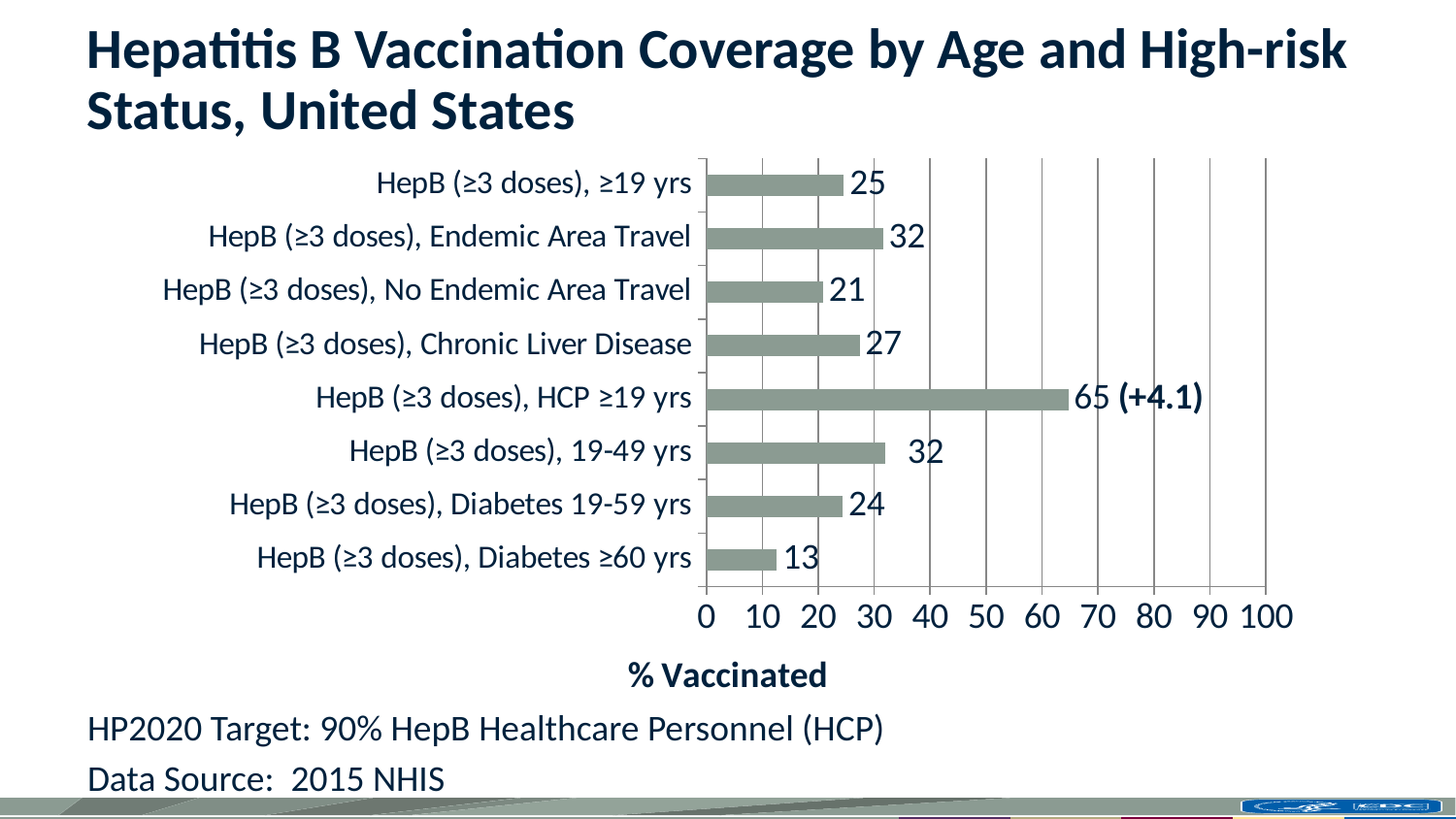
What is the value for HepB (≥3 doses), Chronic Liver Disease? 27 Is the value for HepB (≥3 doses), HCP ≥19 yrs greater or less than 60? greater What is the value for HepB (≥3 doses), Diabetes ≥60 yrs? 13 What kind of chart is shown on the slide? bar chart What is the HP2020 target for HepB Healthcare Personnel (HCP) stated on the slide? 90% What is the label of the x axis? % Vaccinated Which category has the highest value? HepB (≥3 doses), HCP ≥19 yrs What is the difference between the values for HepB (≥3 doses), Endemic Area Travel and HepB (≥3 doses), No Endemic Area Travel? 11 Which category has the lowest value? HepB (≥3 doses), Diabetes ≥60 yrs What is the value for HepB (≥3 doses), HCP ≥19 yrs? 65 How many categories are shown in the chart? 8 Which is larger, the value for HepB (≥3 doses), ≥19 yrs or HepB (≥3 doses), Diabetes 19-59 yrs? HepB (≥3 doses), ≥19 yrs